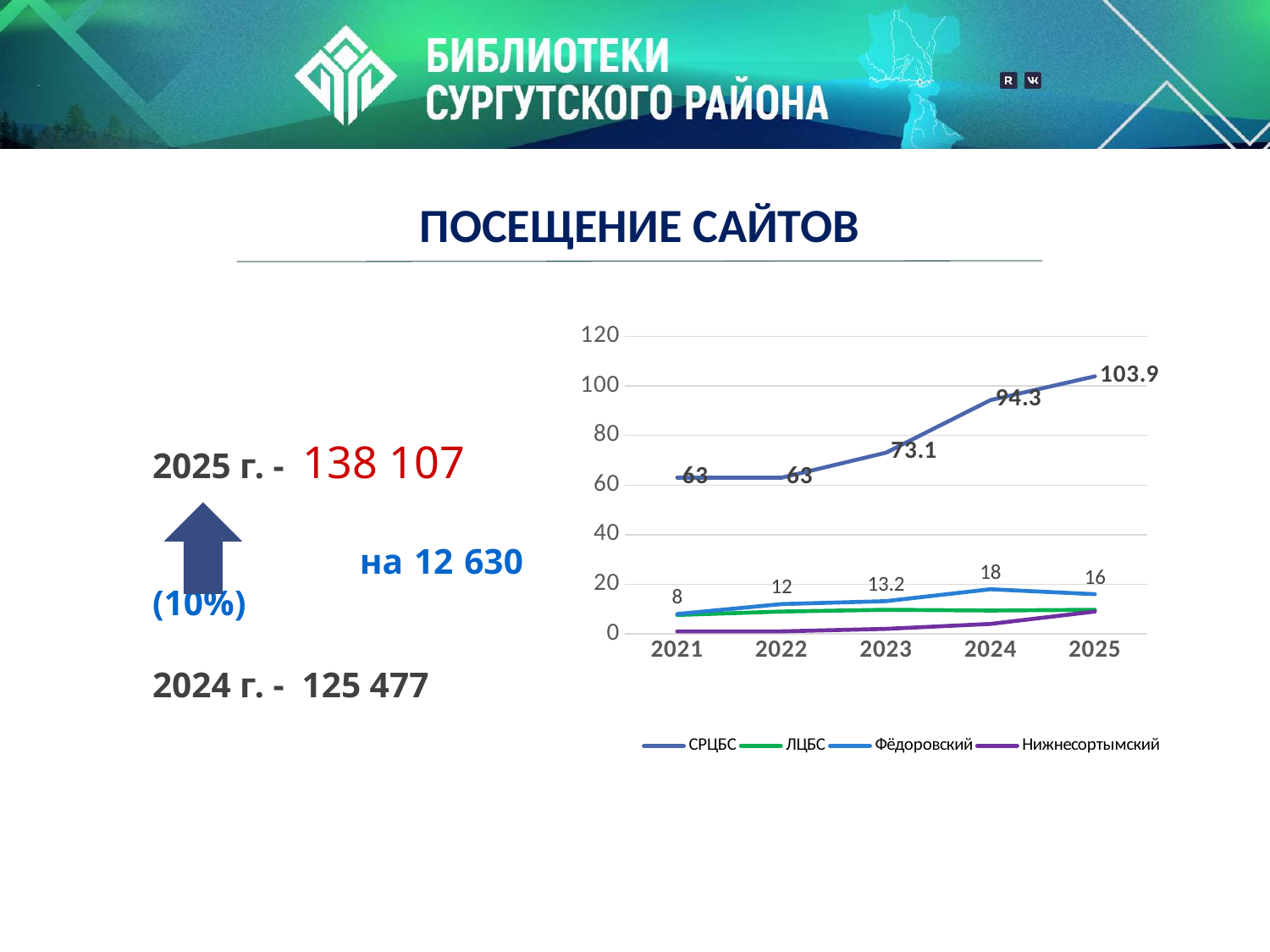
What is the value for СРЦБС in 2025? 103.9 By how much did the value for СРЦБС increase from 2024 to 2025? 9.6 How many years are shown on the x axis of the chart? 5 What is the value for Фёдоровский in 2021? 8 In which year is the value for СРЦБС highest? 2025 In which year is the value for Фёдоровский lowest? 2021 Is the value for Нижнесортымский in 2025 greater or less than 20? less Which series has the larger value in 2025, СРЦБС or Фёдоровский? СРЦБС What kind of chart is shown on the slide? line chart How many series does the chart legend list? 4 What is the value for СРЦБС in 2023? 73.1 What is the value for Фёдоровский in 2024? 18